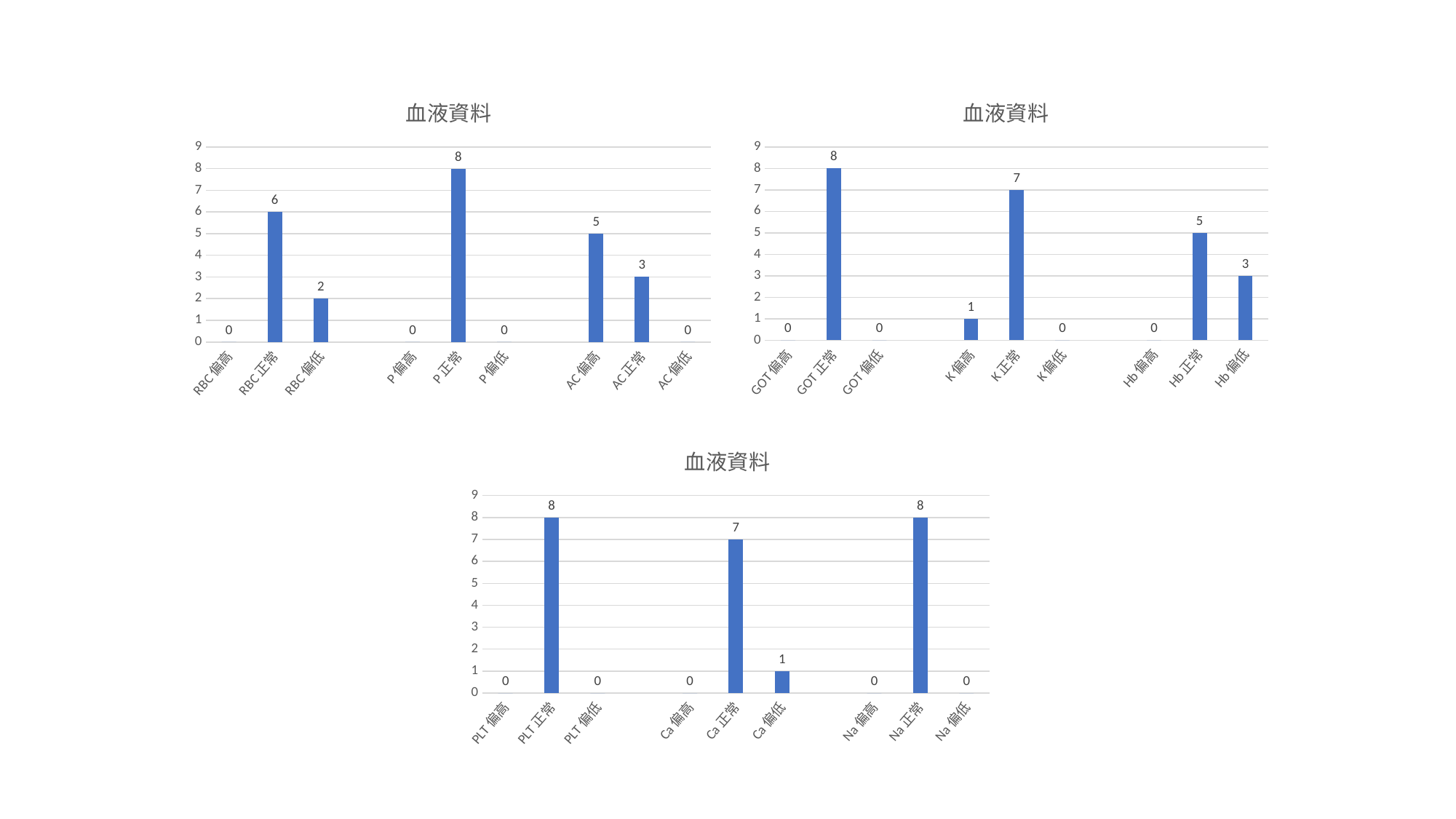
In the top-right chart, which is larger, the value for Hb 正常 or Hb 偏低? Hb 正常 In the top-left chart, which category has the highest value? P 正常 What kind of chart is the bottom chart? bar chart In the top-left chart, how many categories are shown on the x axis? 9 In the bottom chart, what is the value for Ca 正常? 7 In the top-right chart, what is the value for K 正常? 7 In the top-right chart, what is the value for K 偏高? 1 In the bottom chart, what is the difference between the values for PLT 正常 and Ca 偏低? 7 In the top-left chart, what is the value for RBC 正常? 6 In the top-right chart, which category has the highest value? GOT 正常 In the top-left chart, what is the difference between the values for AC 偏高 and AC 正常? 2 What is the title of the top-left chart? 血液資料